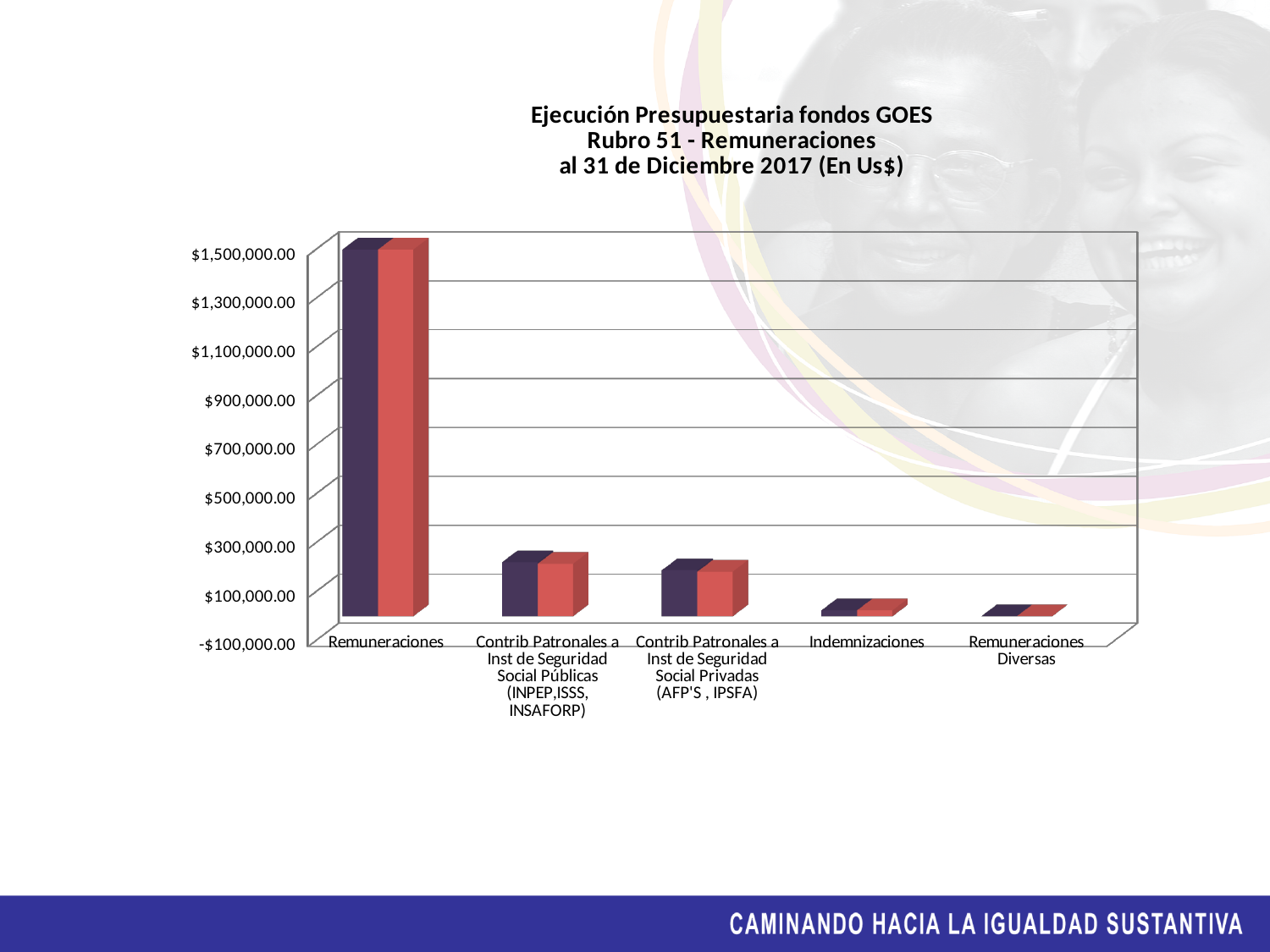
Is the value for Indemnizaciones greater or less than $100,000.00? less Is the value for Contrib Patronales a Inst de Seguridad Social Públicas (INPEP,ISSS, INSAFORP) greater or less than $100,000.00? greater Do the values generally rise or fall moving from left to right along the x axis? fall What is the title of the chart? Ejecución Presupuestaria fondos GOES Rubro 51 - Remuneraciones al 31 de Diciembre 2017 (En Us$) Is the value for Contrib Patronales a Inst de Seguridad Social Privadas (AFP'S , IPSFA) greater or less than $300,000.00? less How many categories are shown on the x axis of the chart? 5 Which is larger, the value for Remuneraciones or the value for Indemnizaciones? Remuneraciones Which category has the highest value in the chart? Remuneraciones Which category has the lowest value in the chart? Remuneraciones Diversas What kind of chart is shown on the slide? bar chart Which is larger, the value for Contrib Patronales a Inst de Seguridad Social Públicas or the value for Remuneraciones Diversas? Contrib Patronales a Inst de Seguridad Social Públicas